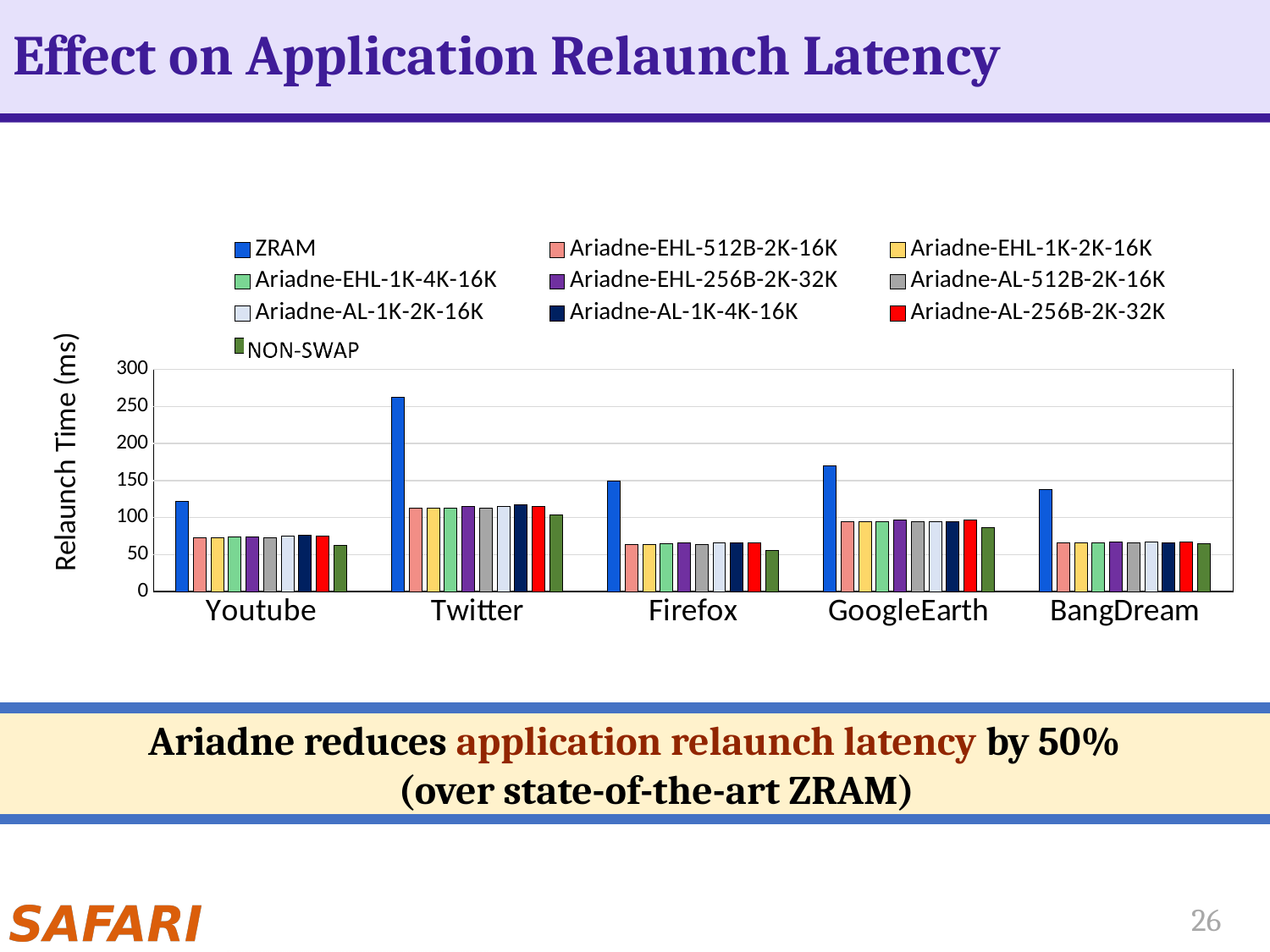
Which is larger: the ZRAM relaunch time for Twitter or the ZRAM relaunch time for GoogleEarth? Twitter Is the ZRAM relaunch time for GoogleEarth greater or less than 150 ms? greater Is the Ariadne-EHL-512B-2K-16K relaunch time for Twitter greater or less than 100 ms? greater For which application is the ZRAM relaunch time highest? Twitter How many series does the legend list? 10 What is the label of the y axis? Relaunch Time (ms) For which application is the ZRAM relaunch time lowest? Youtube What kind of chart is shown on the slide? bar chart For Youtube, which is larger: the ZRAM bar or the NON-SWAP bar? ZRAM How many applications (categories) are shown on the x axis? 5 Is the ZRAM relaunch time for Twitter greater or less than 250 ms? greater